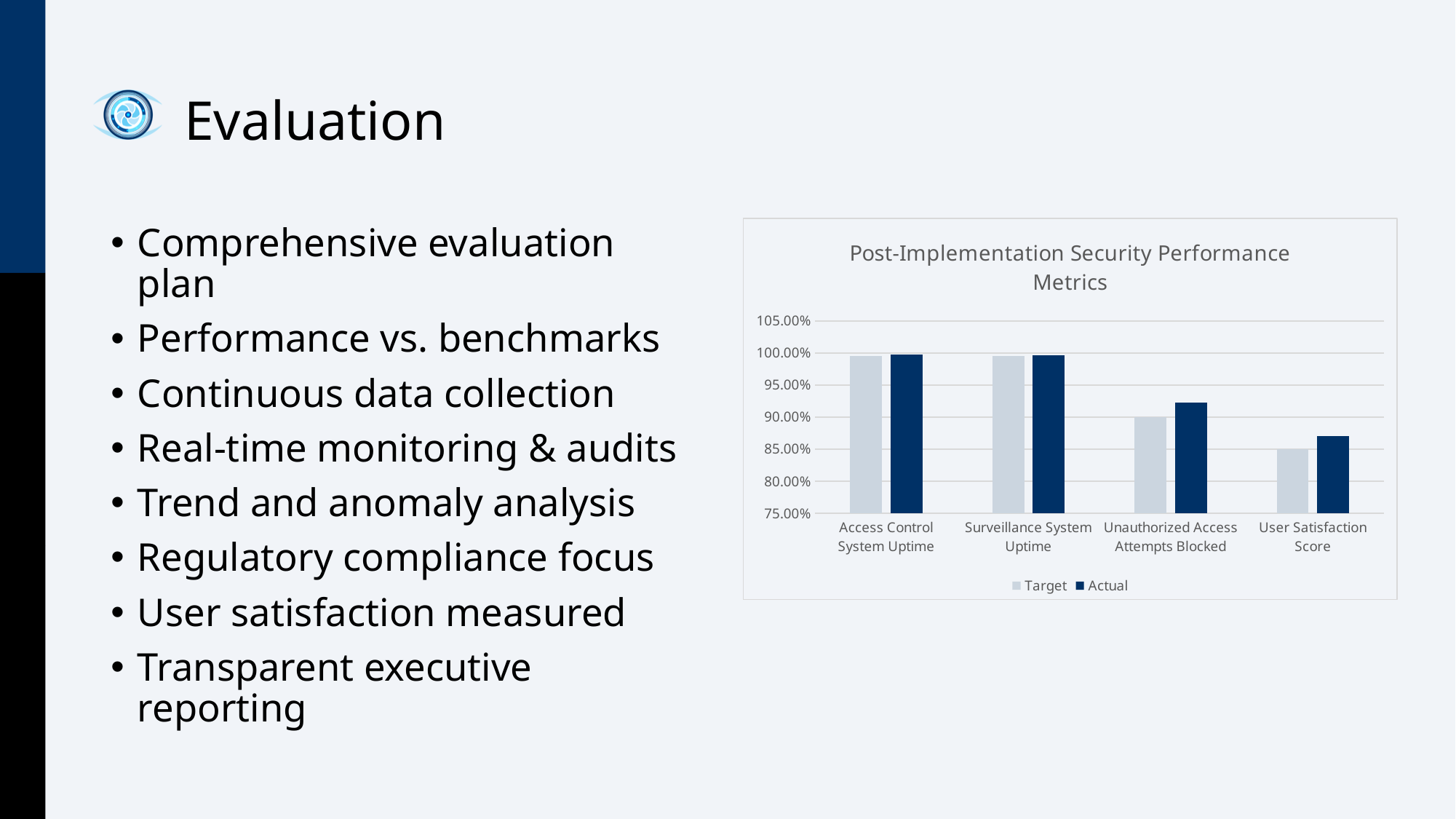
What is the title of the chart? Post-Implementation Security Performance Metrics Which category has the lowest Actual value? User Satisfaction Score Is the Actual value for Unauthorized Access Attempts Blocked greater or less than 90.00%? greater What is the Target value for Unauthorized Access Attempts Blocked? 90.00% Is the Actual value for User Satisfaction Score greater or less than 85.00%? greater How many series does the chart legend list? 2 What are the two series named in the chart legend? Target and Actual What is the Target value for User Satisfaction Score? 85.00% What kind of chart is shown on the slide? bar chart Which category has the lowest Target value? User Satisfaction Score How many categories are shown on the x axis of the chart? 4 For User Satisfaction Score, which is larger: the Target value or the Actual value? Actual